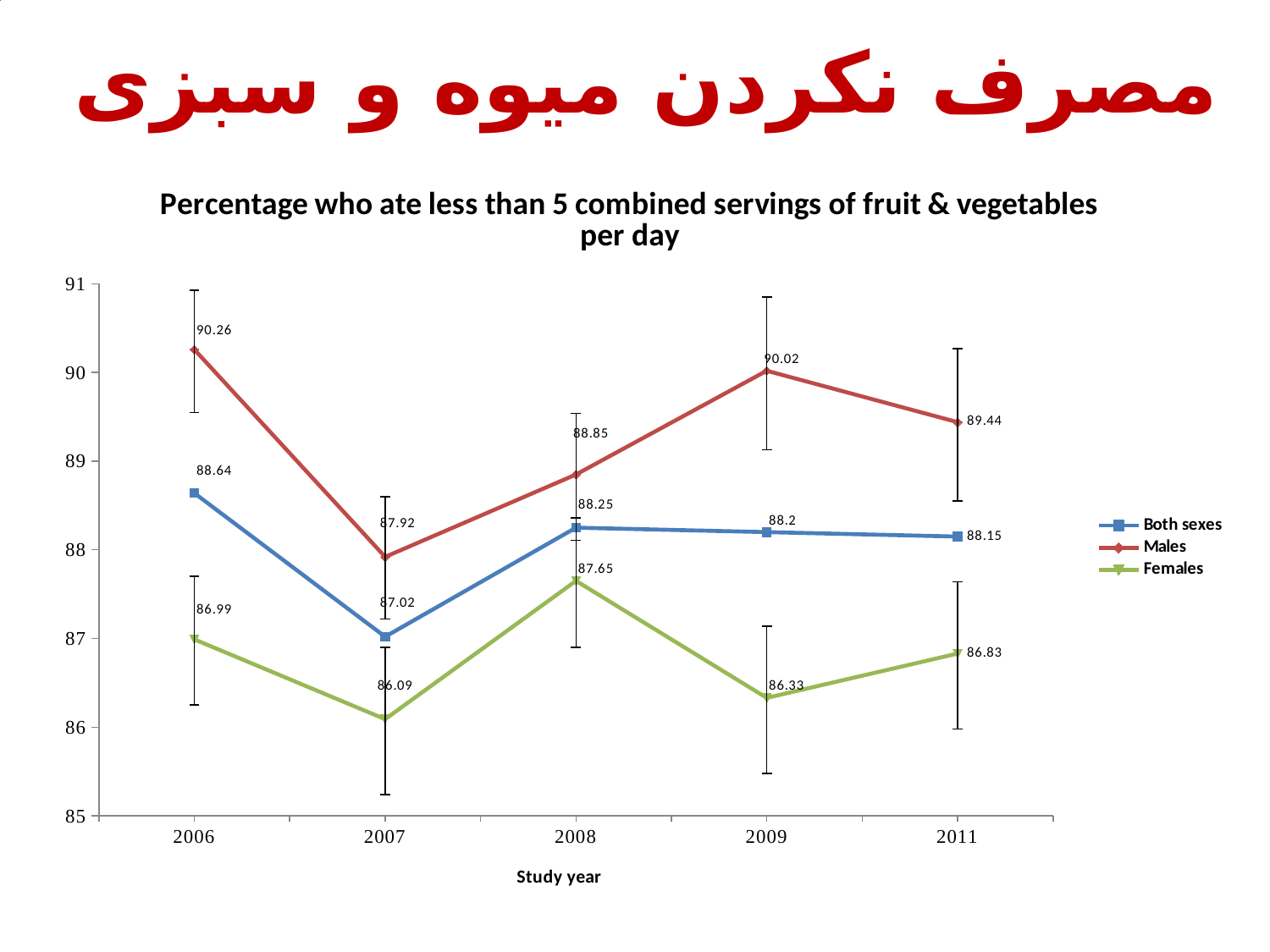
What is the label of the x axis? Study year What is the value for Males in 2006? 90.26 What is the value for Females in 2009? 86.33 In which year is the Males value lowest? 2007 What type of chart is shown on the slide? Line chart Which is larger, the Both sexes value in 2008 or in 2009? 2008 What is the value for Both sexes in 2011? 88.15 How many study years are plotted on the x axis? 5 How many series does the legend list? 3 In which year is the Females value highest? 2008 What is the difference between the Males and Females values in 2006? 3.27 Does the Males value rise or fall from 2006 to 2007? Fall